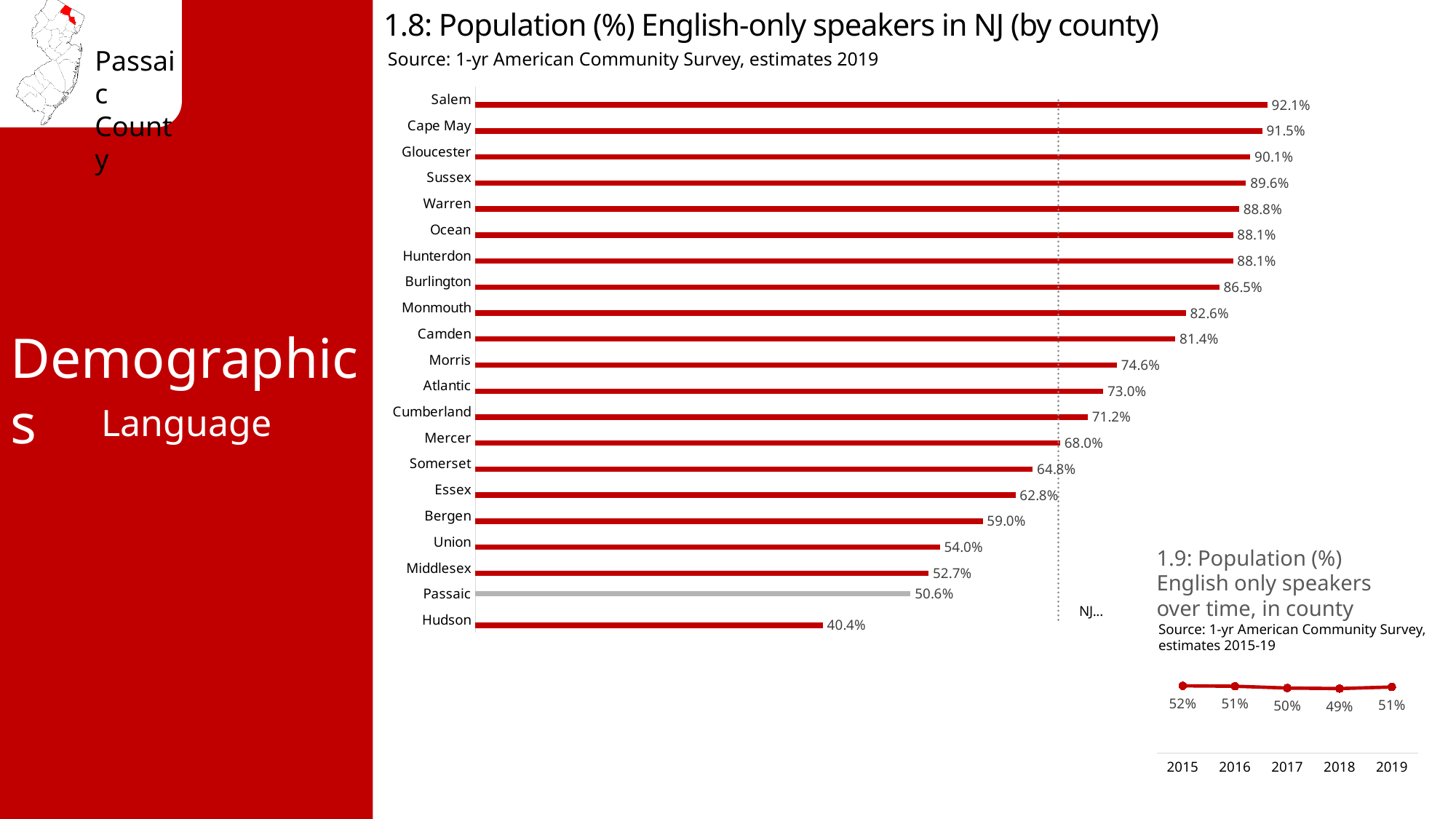
What kind of chart is chart 1.8 (Population (%) English-only speakers in NJ by county)? Bar chart In chart 1.9 (Population (%) English only speakers over time, in county), what is the value for 2018? 49% In chart 1.8 (Population (%) English-only speakers in NJ by county), what is the value for Passaic? 50.6% In chart 1.8 (Population (%) English-only speakers in NJ by county), what is the value for Morris? 74.6% In chart 1.9 (Population (%) English only speakers over time, in county), which year has the highest value? 2015 In chart 1.8 (Population (%) English-only speakers in NJ by county), which county has the highest value? Salem In chart 1.9 (Population (%) English only speakers over time, in county), how many years are plotted? 5 In chart 1.8 (Population (%) English-only speakers in NJ by county), what is the difference between Salem and Hudson? 51.7% In chart 1.8 (Population (%) English-only speakers in NJ by county), which county has the lowest value? Hudson In chart 1.8 (Population (%) English-only speakers in NJ by county), which is larger, Bergen or Union? Bergen In chart 1.8 (Population (%) English-only speakers in NJ by county), which county's bar is coloured grey instead of red? Passaic In chart 1.8 (Population (%) English-only speakers in NJ by county), how many counties are shown? 21